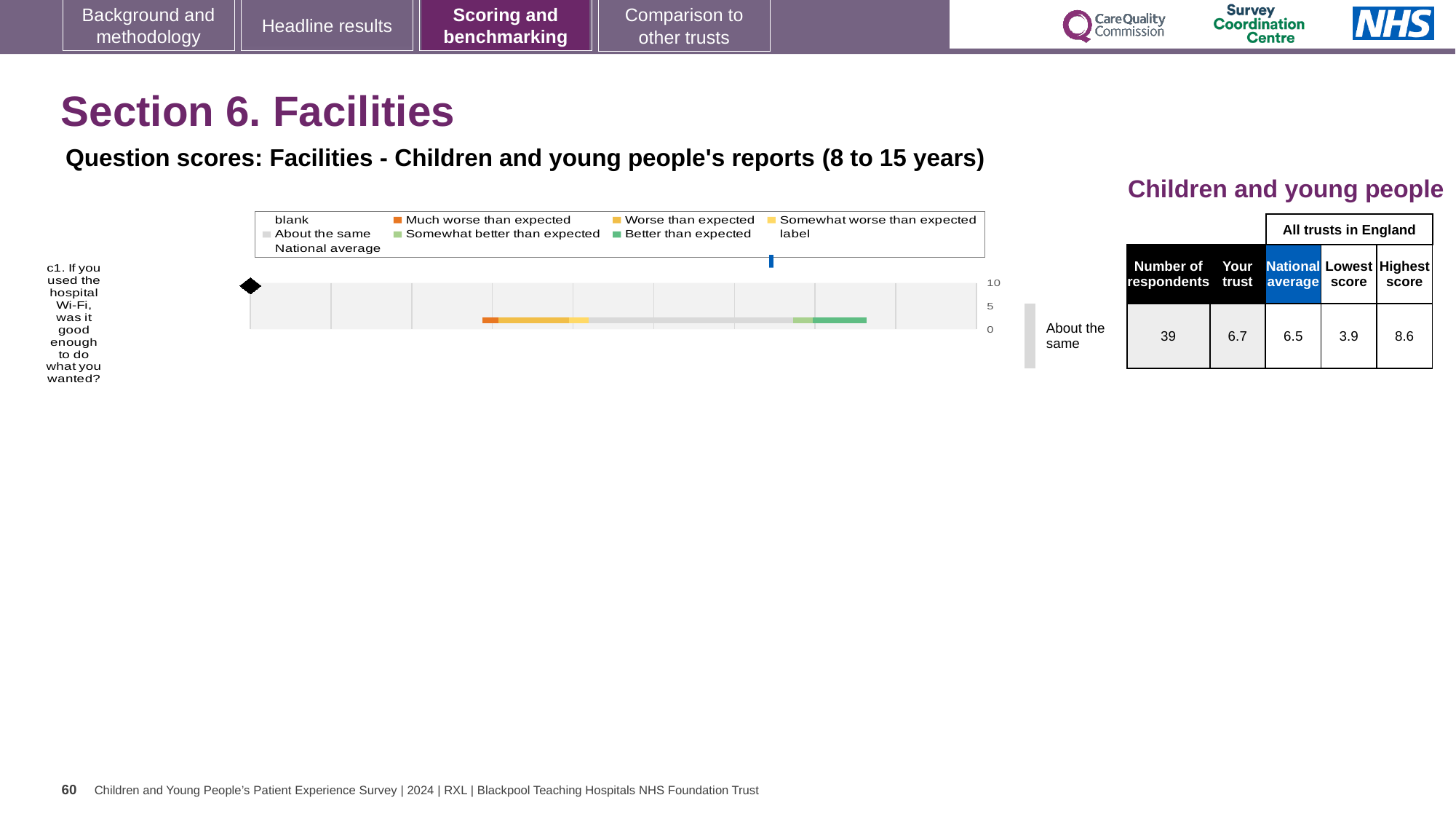
Which is larger for question c1, the 'Your trust' score or the national average? Your trust What is the difference between the highest score and the lowest score for question c1? 4.7 How many questions (categories) are plotted in the chart? 1 What is the lowest score among all trusts in England for question c1? 3.9 How many respondents answered question c1? 39 What rating category is given for question c1 next to the chart? About the same What is the national average score for question c1 shown beside the chart? 6.5 What is the highest score among all trusts in England for question c1? 8.6 Which question is plotted in the chart? c1. If you used the hospital Wi-Fi, was it good enough to do what you wanted? What is the 'Your trust' score for question c1 shown beside the chart? 6.7 What is the highest value shown on the chart's axis? 10 What kind of chart is shown on the slide? bar chart